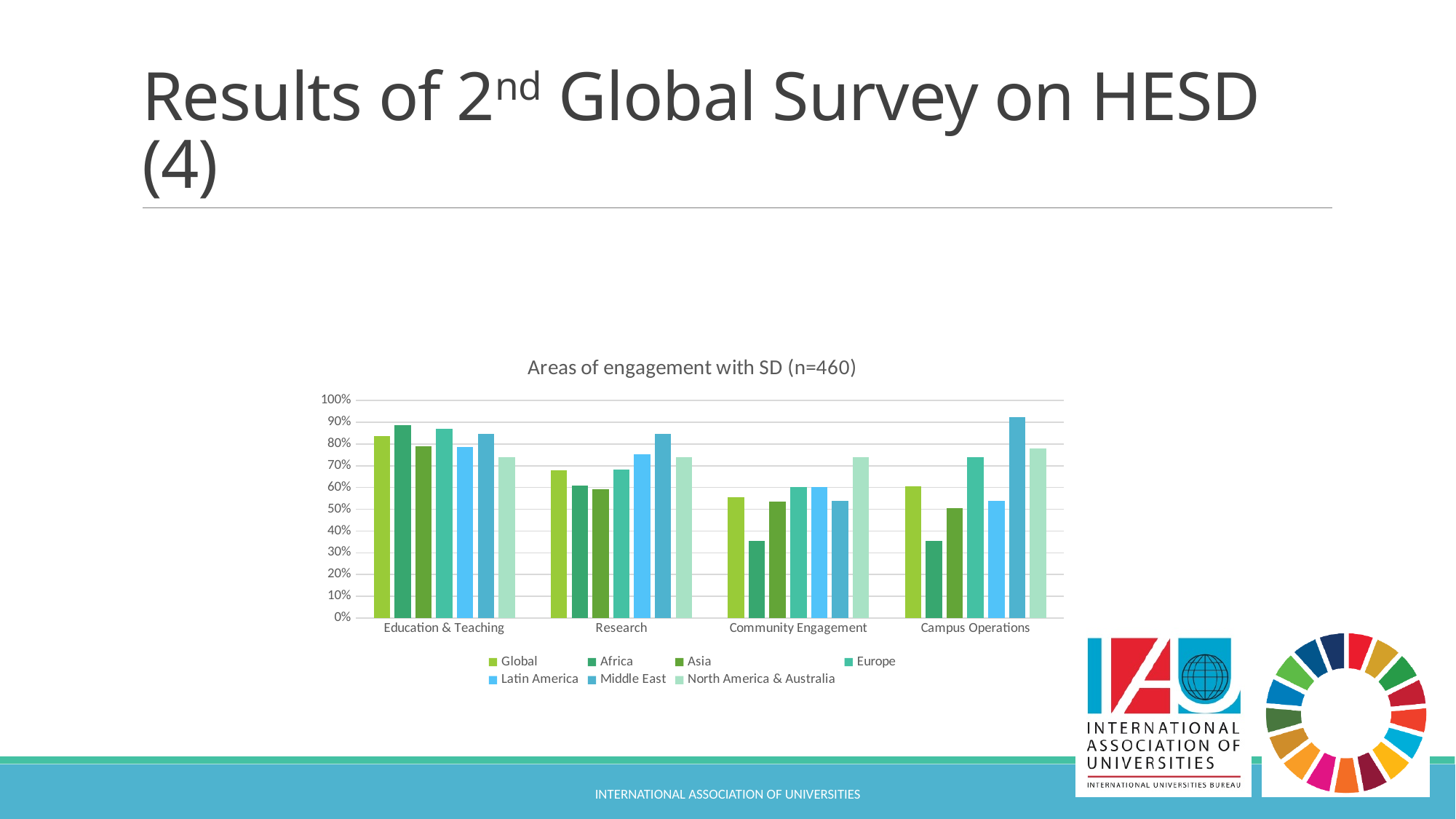
Which series has the highest value in Research? Middle East How many series does the chart's legend list? 7 Which series has the lowest value in Community Engagement? Africa Is the value for North America & Australia in Community Engagement greater or less than 70%? greater Is the value for Africa in Community Engagement greater or less than 40%? less Is the value for Global in Research greater or less than 60%? greater Which series has the highest value in Campus Operations? Middle East How many categories are shown on the x axis of the chart? 4 Which is larger for the Global series: Education & Teaching or Community Engagement? Education & Teaching What is the title of the chart? Areas of engagement with SD (n=460) What kind of chart is shown on the slide? bar chart